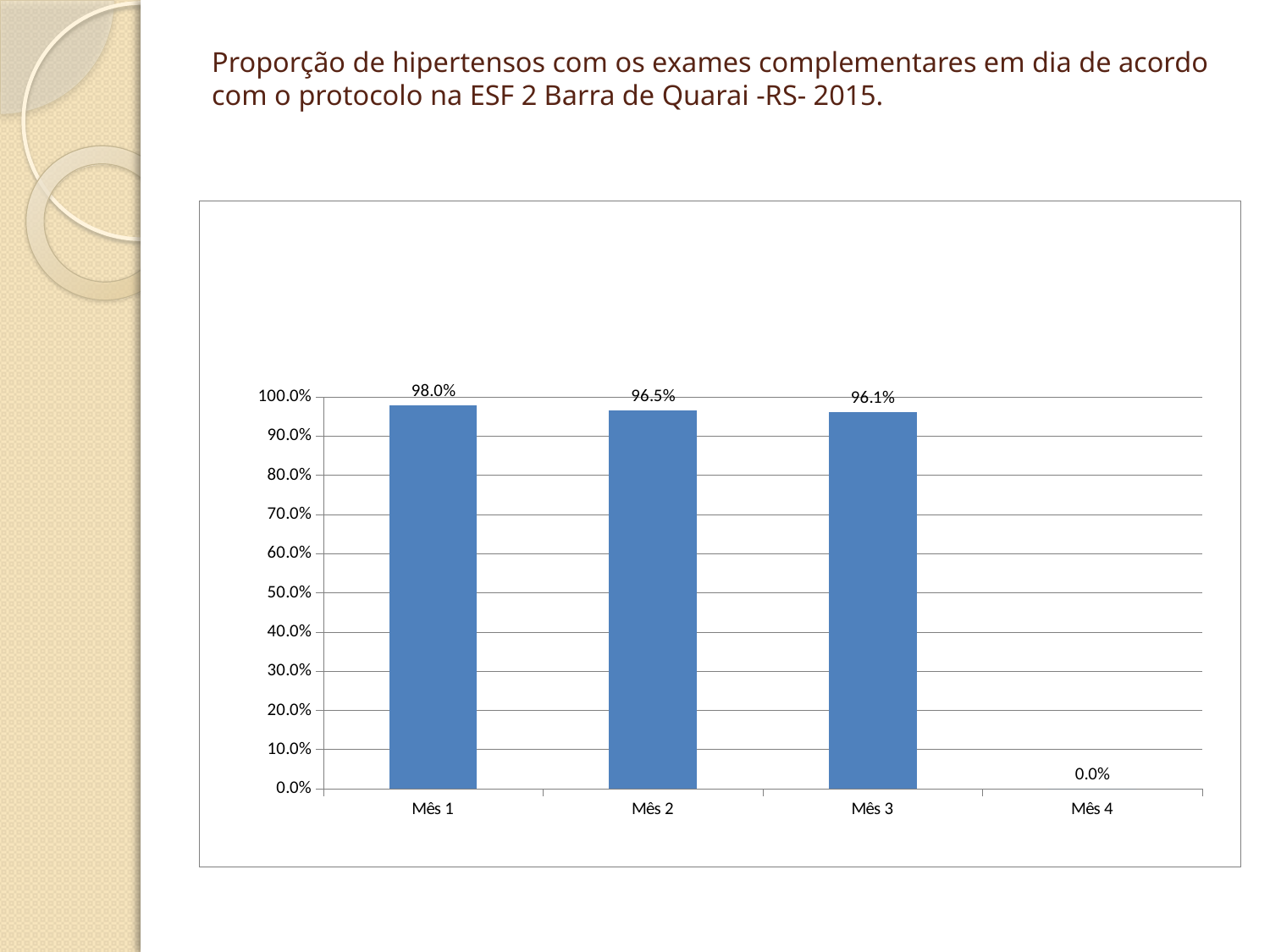
What is the value for Mês 4? 0.0% What is the difference between the values for Mês 1 and Mês 2? 1.5% What is the value for Mês 2? 96.5% Which month has the highest value? Mês 1 How many categories are shown on the x axis? 4 Which is larger, the value for Mês 1 or the value for Mês 3? Mês 1 What is the value for Mês 1? 98.0% Do the values rise or fall from Mês 1 to Mês 3? Fall What is the value for Mês 3? 96.1% What kind of chart is shown on the slide? Bar chart Which month has the lowest value? Mês 4 What is the difference between the values for Mês 1 and Mês 3? 1.9%